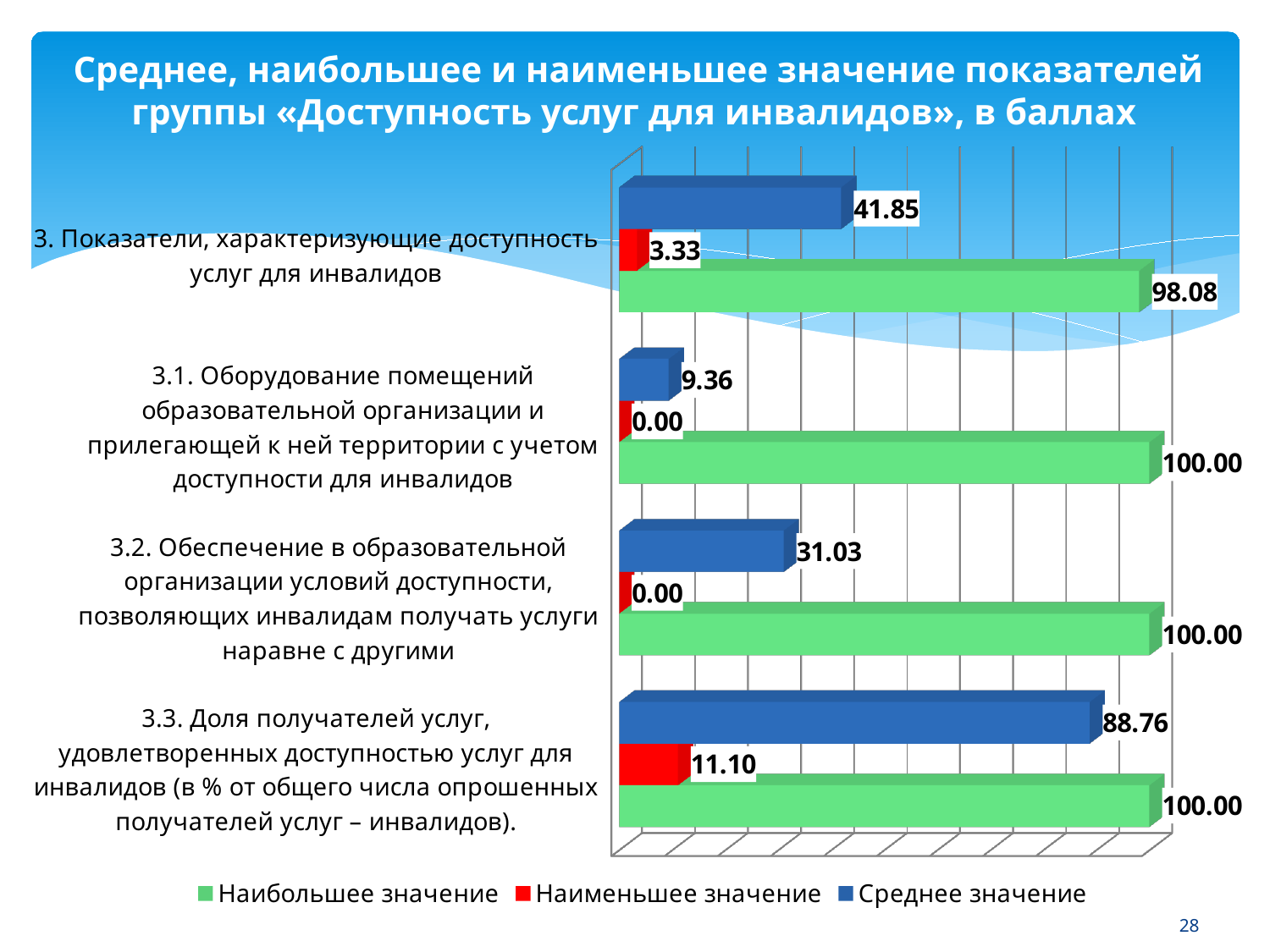
Какое наименьшее значение показателя «3.2. Обеспечение в образовательной организации условий доступности»? 0.00 Какое среднее значение показателя «3.3. Доля получателей услуг, удовлетворенных доступностью услуг для инвалидов»? 88.76 У какого показателя самое низкое среднее значение? 3.1. Оборудование помещений образовательной организации и прилегающей к ней территории с учетом доступности для инвалидов У какого показателя самое высокое среднее значение? 3.3. Доля получателей услуг, удовлетворенных доступностью услуг для инвалидов Какого типа эта диаграмма? Столбчатая (линейчатая) диаграмма с горизонтальными полосами Сколько показателей (категорий) представлено на диаграмме? 4 Какое среднее значение показателя «3.1. Оборудование помещений образовательной организации и прилегающей к ней территории»? 9.36 Какое наибольшее значение показателя «3. Показатели, характеризующие доступность услуг для инвалидов»? 98.08 Что больше: среднее значение показателя 3 или среднее значение показателя 3.2? Среднее значение показателя 3 (41.85) Сколько рядов данных указано в легенде диаграммы? 3 На сколько среднее значение показателя 3.3 больше среднего значения показателя 3.2? 57.73 Какое наименьшее значение показателя «3. Показатели, характеризующие доступность услуг для инвалидов»? 3.33